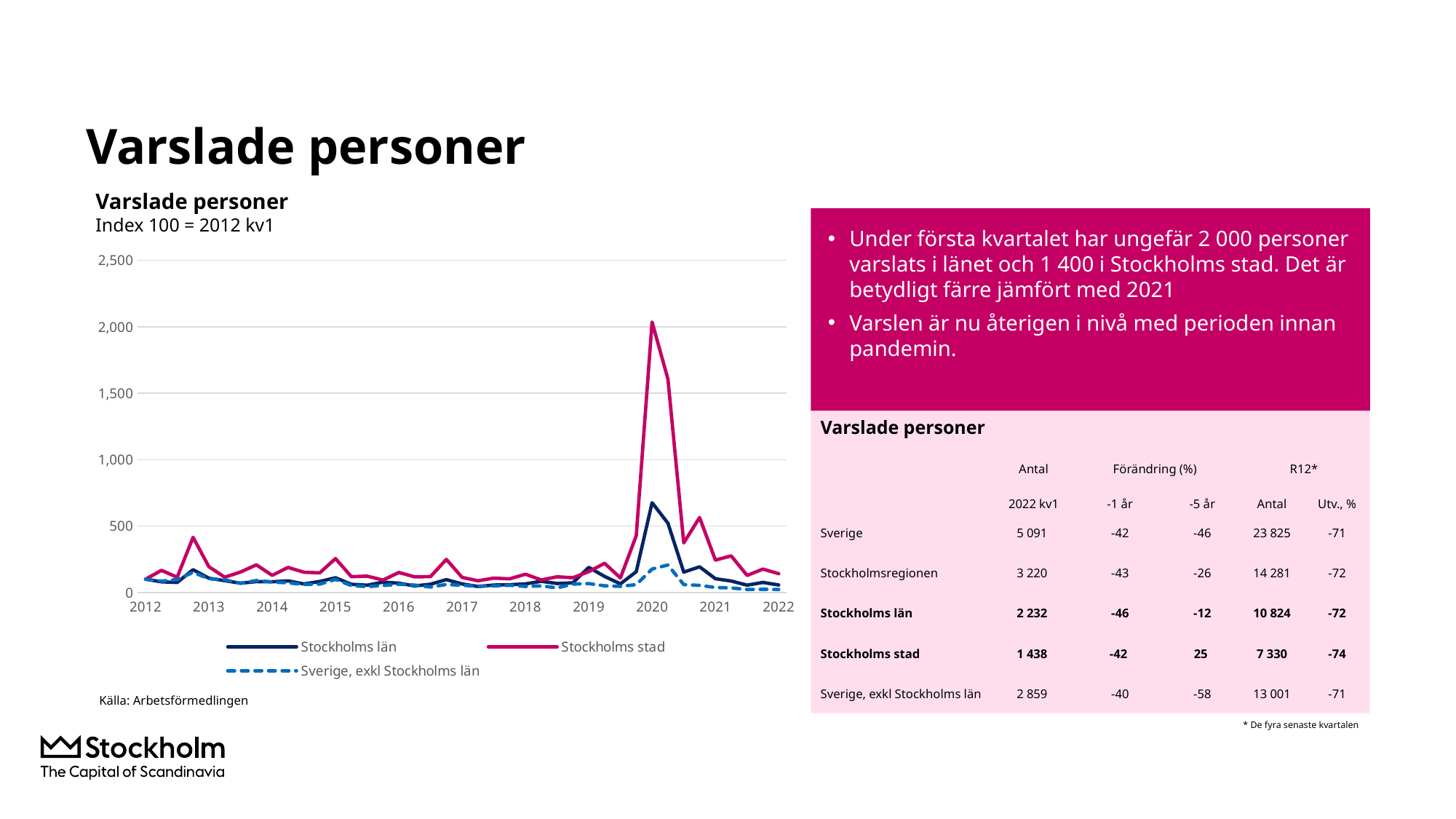
Do the values for Stockholms stad rise or fall from the 2020 peak to 2022? fall Is the peak value for Stockholms stad in 2020 greater or less than 1,500? greater What is the title of the chart? Varslade personer How many series does the chart legend list? 3 How many year labels are shown on the x axis? 11 Is the peak value for Stockholms län in 2020 greater or less than 1,000? less Is the peak value for Sverige, exkl Stockholms län in 2020 greater or less than 500? less What is the index base stated under the chart title? Index 100 = 2012 kv1 What kind of chart is shown on the slide? line chart Which series reaches the highest value in 2020? Stockholms stad At the 2020 peak, which is larger: Stockholms stad or Stockholms län? Stockholms stad Which series is drawn with a dashed line? Sverige, exkl Stockholms län